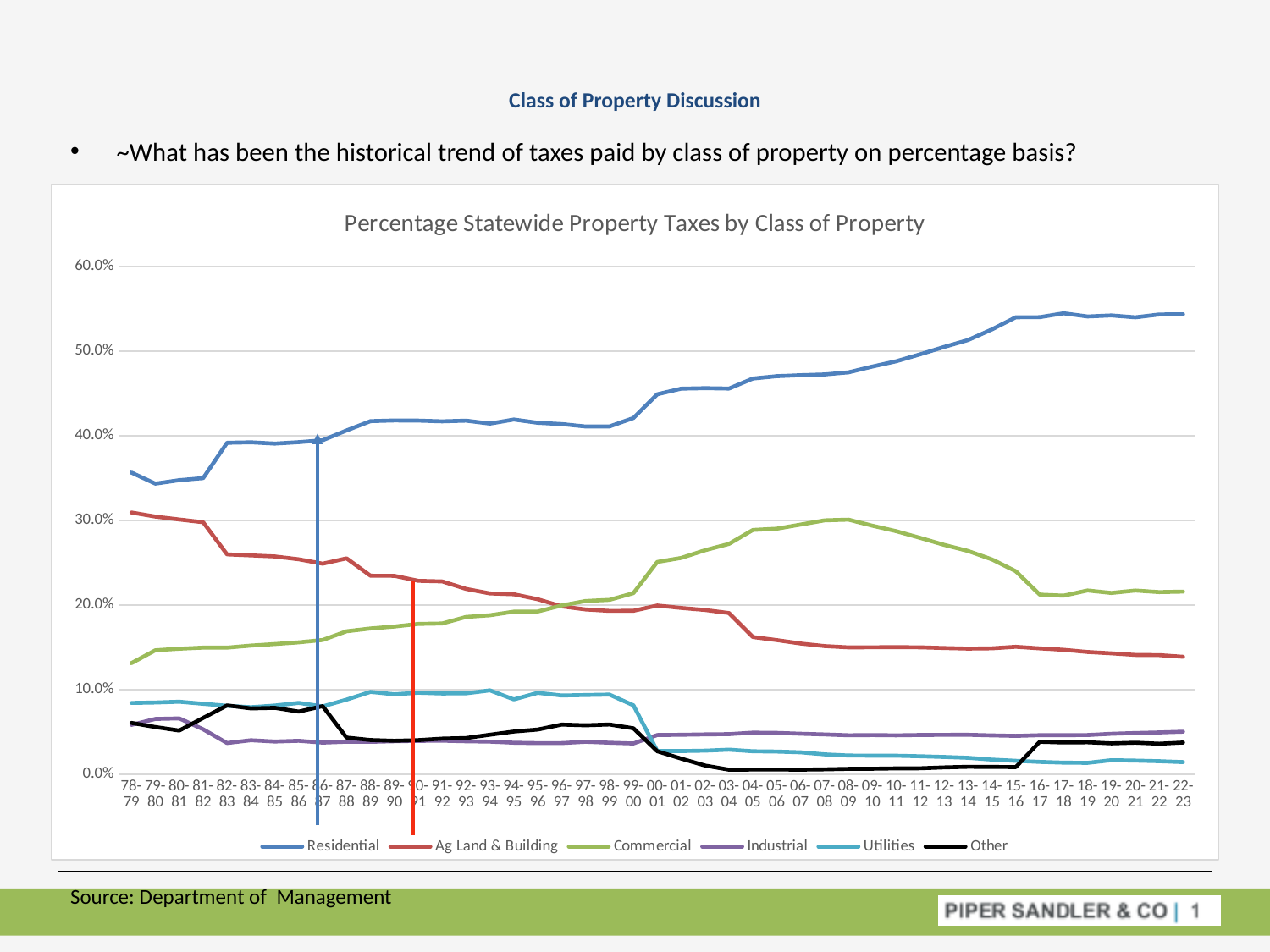
Is the Commercial value for 78-79 greater or less than 20.0%? less Does the Residential series generally rise or fall from 78-79 to 22-23? Rise Which series has the lowest value in 22-23? Utilities What kind of chart is shown on the slide? Line chart What is the title of the chart? Percentage Statewide Property Taxes by Class of Property Which series has the highest value in 22-23? Residential Which series is drawn in black? Other How many fiscal-year points are plotted along the x axis? 45 In 22-23, which is larger: Commercial or Ag Land & Building? Commercial How many series does the chart legend list? 6 Is the Residential value for 22-23 greater or less than 50.0%? greater Does the Ag Land & Building series generally rise or fall from 78-79 to 22-23? Fall